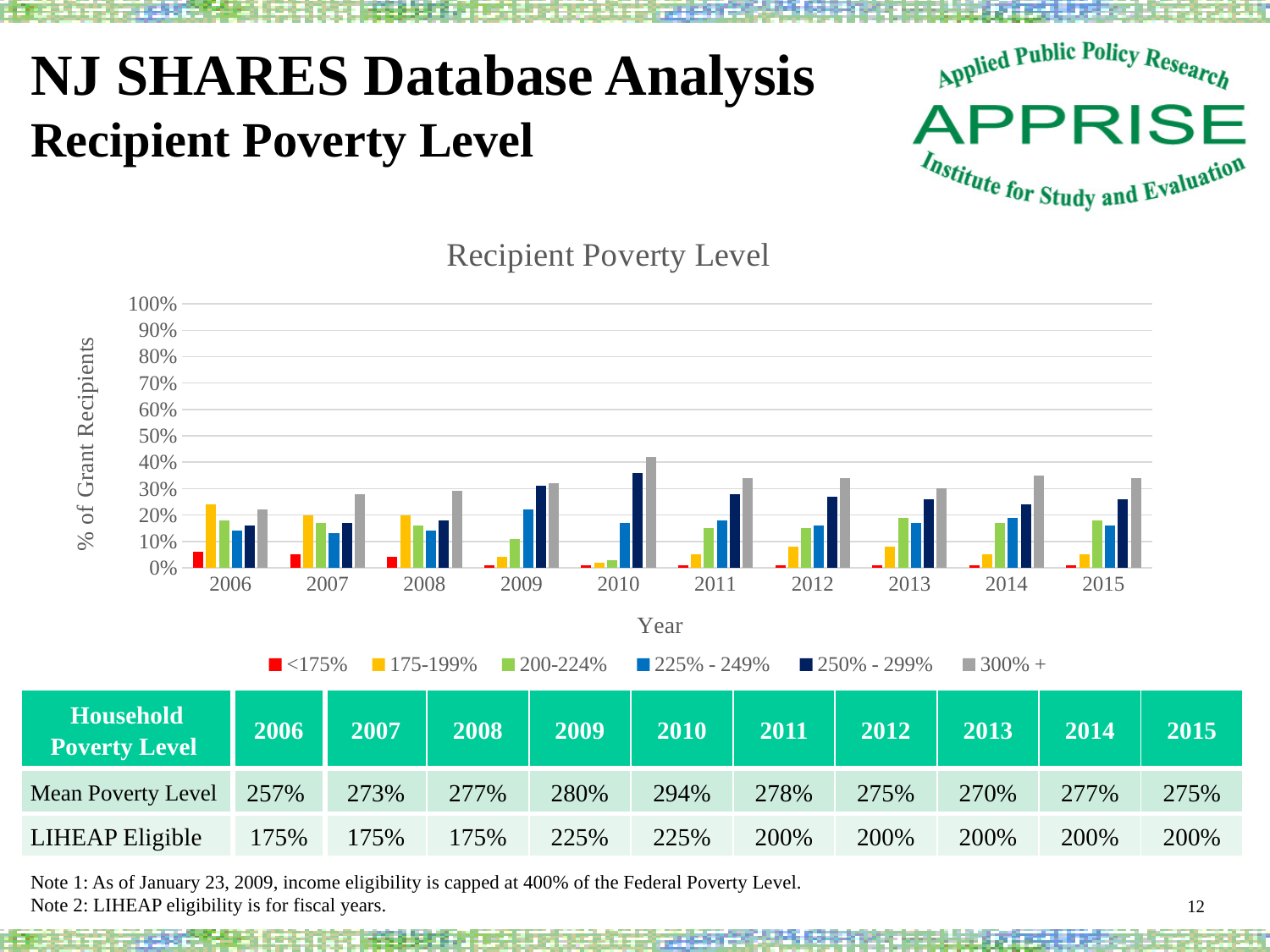
Is the value for <175% in 2006 greater or less than 10%? less Is the value for 300% + in 2010 greater or less than 30%? greater How many years are shown along the x axis of the chart? 10 Does the share of recipients in the <175% group rise or fall from 2006 to 2015? fall In which year is the 300% + bar the tallest? 2010 How many series does the chart legend list? 6 Which poverty level group has the smallest share of grant recipients in 2006? <175% In which year is the 175-199% bar the tallest? 2006 What is the label on the vertical axis of the chart? % of Grant Recipients What is the title of the chart? Recipient Poverty Level In 2006, which is larger: the 175-199% bar or the 250% - 299% bar? 175-199% What kind of chart is shown on the slide? bar chart